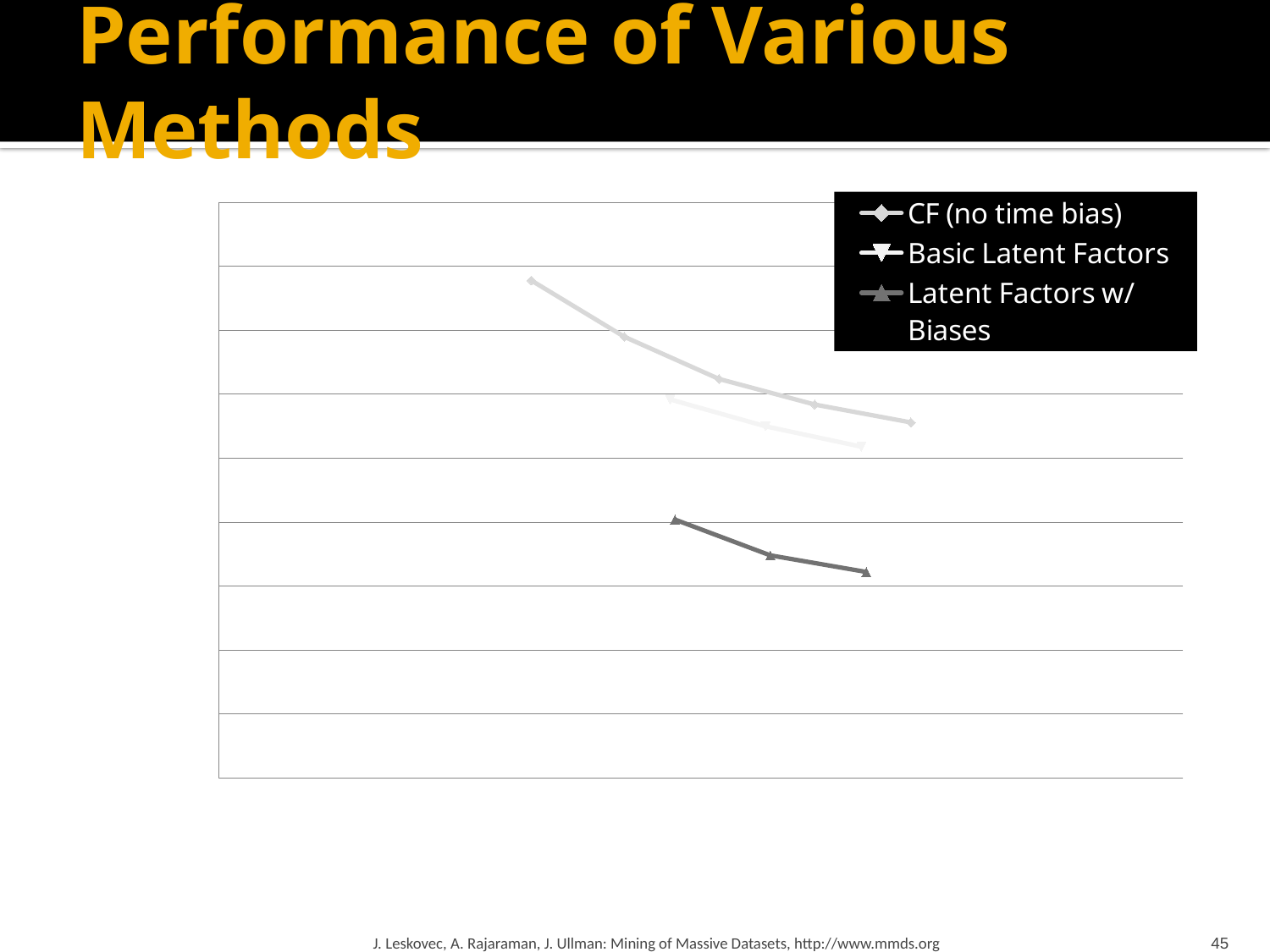
How many series does the legend list? 3 Which series is listed first in the legend? CF (no time bias) What kind of chart is shown on the slide? line chart Do the values for the Basic Latent Factors series rise or fall from left to right? fall Do the values for the Latent Factors w/ Biases series rise or fall from left to right? fall Which series is listed last in the legend? Latent Factors w/ Biases How many data points are plotted for the CF (no time bias) series? 5 Which series is plotted highest on the chart? CF (no time bias) Do the values for the CF (no time bias) series rise or fall from left to right? fall Which series is plotted lowest on the chart? Latent Factors w/ Biases How many data points are plotted for the Latent Factors w/ Biases series? 3 Which series is plotted higher, CF (no time bias) or Latent Factors w/ Biases? CF (no time bias)